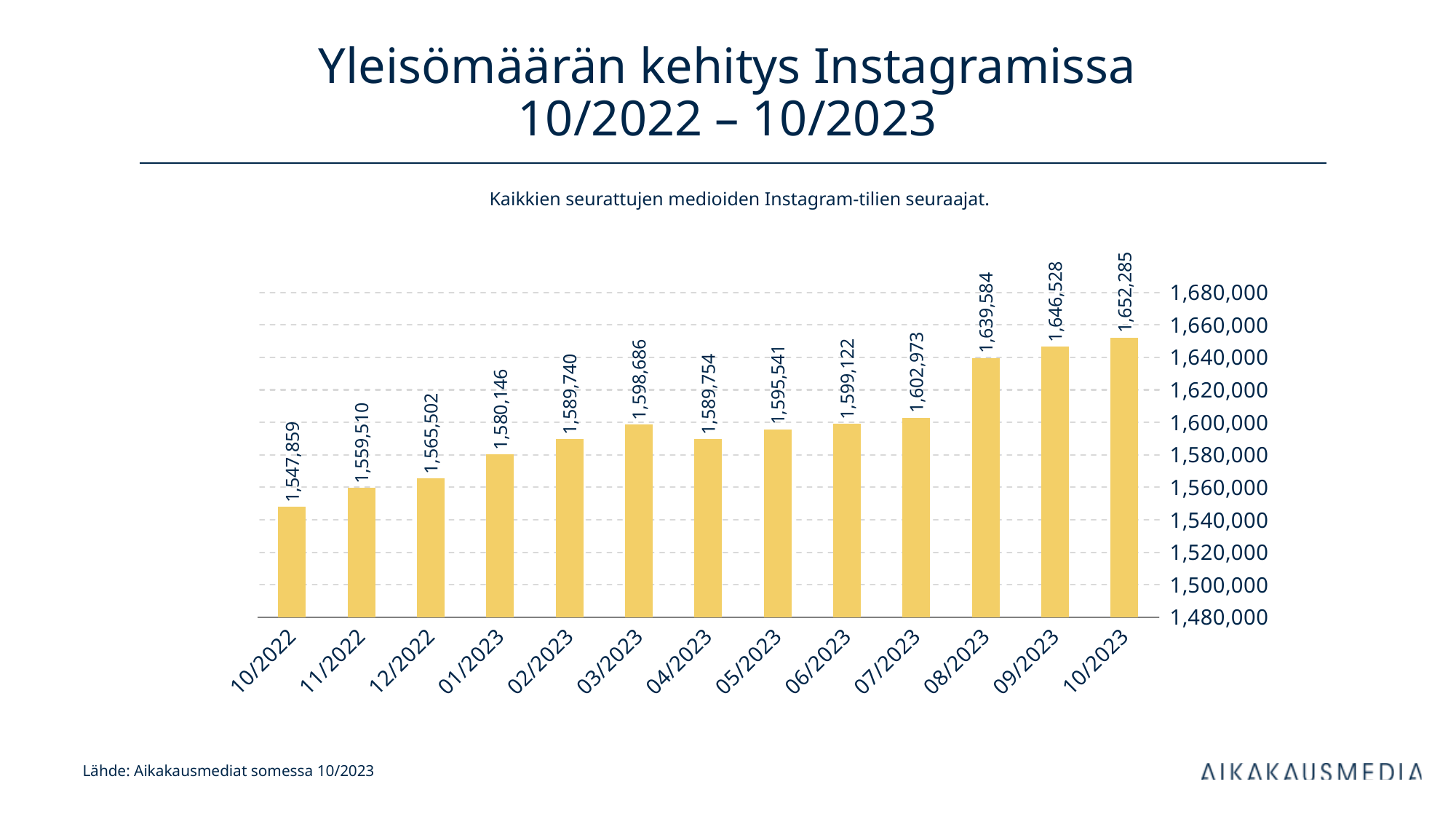
What is the difference between the values for 10/2023 and 10/2022? 104,426 What is the value for 08/2023? 1,639,584 Which is larger, the value for 03/2023 or the value for 04/2023? 03/2023 Do the values generally rise or fall from 10/2022 to 10/2023? Rise How many months are shown on the x axis? 13 What is the value for 04/2023? 1,589,754 What is the difference between the values for 08/2023 and 07/2023? 36,611 What is the value for 10/2022? 1,547,859 Which month has the highest value? 10/2023 What kind of chart is shown on the slide? Bar chart Is the value for 07/2023 greater or less than 1,600,000? greater Which month has the lowest value? 10/2022